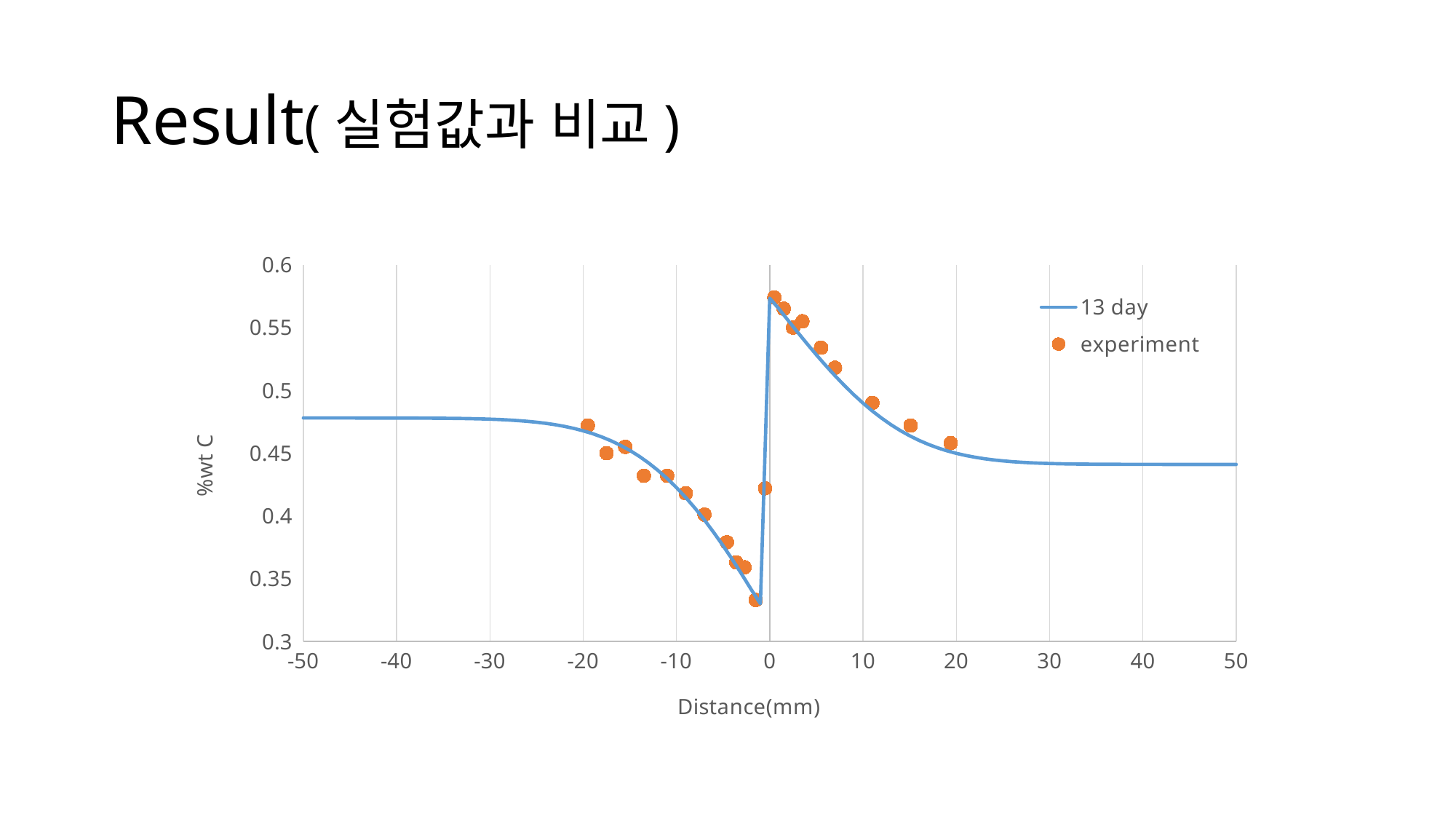
Near which x-axis value does the 13 day line reach its highest point? 0 How many series does the legend list? 2 Does the 13 day line rise or fall as distance increases from 0 mm to 30 mm? fall Which is larger for the 13 day line: the value at -50 mm or the value at 50 mm? the value at -50 mm What are the two series named in the legend? 13 day and experiment What is the label of the x axis? Distance(mm) Is the value of the 13 day line at a distance of -50 mm greater or less than 0.45? greater Is the lowest value of the 13 day line greater or less than 0.35? less Does the 13 day line rise or fall as distance increases from -20 mm to -5 mm? fall Is the peak value of the 13 day line near 0 mm greater or less than 0.55? greater What kind of chart is shown on the slide? line chart